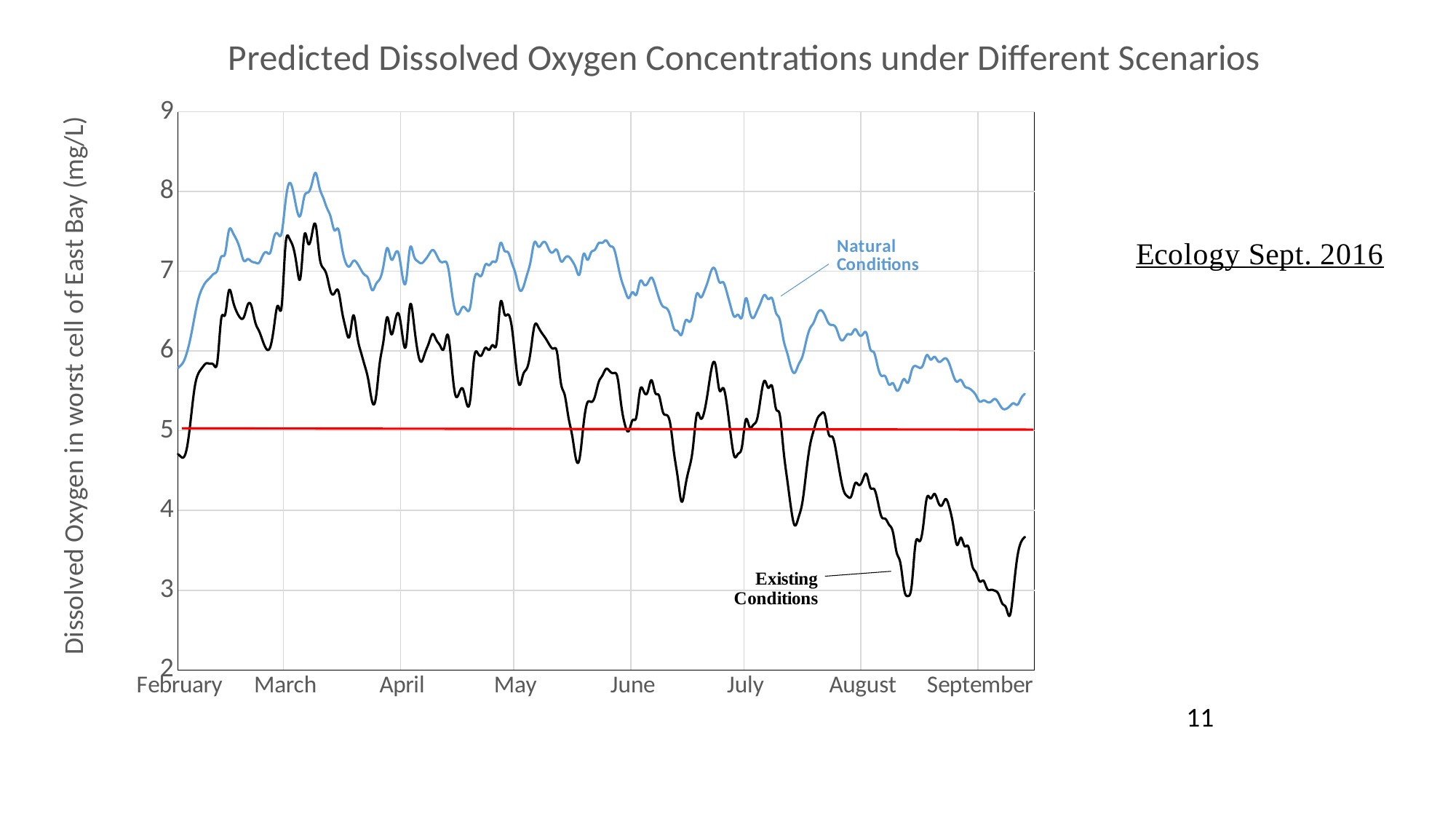
Is the lowest value of the Existing Conditions line greater or less than 3? less What type of chart is shown on the slide? Line chart Is the highest value of the Natural Conditions line greater or less than 8? greater Is the lowest value of the Natural Conditions line greater or less than 5? greater What is the label of the y axis? Dissolved Oxygen in worst cell of East Bay (mg/L) What is the title of the chart? Predicted Dissolved Oxygen Concentrations under Different Scenarios Between June and September, does the Existing Conditions line generally rise or fall? fall At what y-axis value does the flat red horizontal line sit? 5 How many month labels are shown on the x axis? 8 Which line is higher in August, Natural Conditions or Existing Conditions? Natural Conditions How many labeled series are plotted on the chart? 2